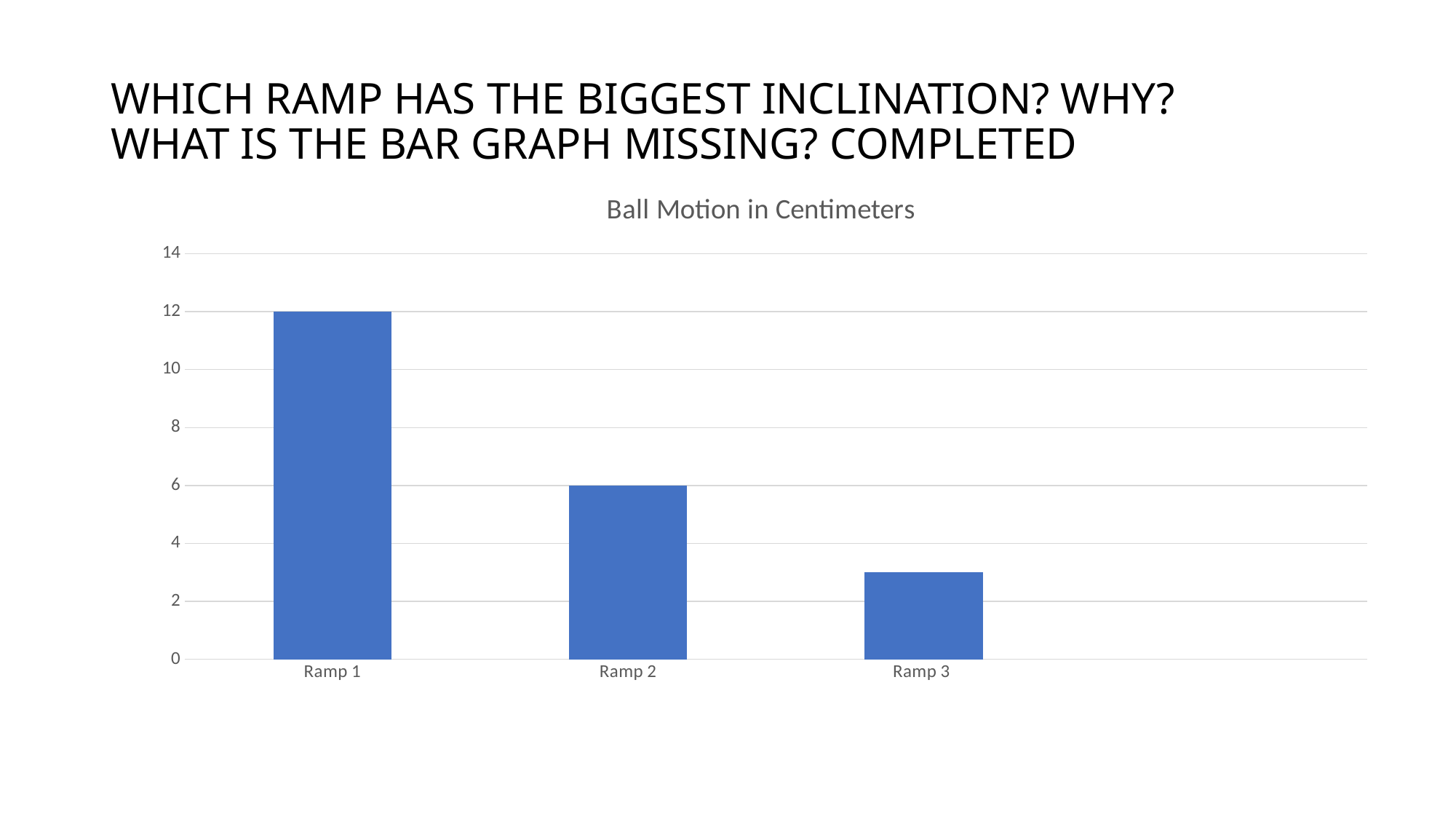
Which ramp has the lowest value? Ramp 3 How many ramps are shown on the x axis of the chart? 3 What is the value for Ramp 1? 12 Is the value for Ramp 3 greater or less than 4? less Is the value for Ramp 3 greater or less than 2? greater What is the difference between the values for Ramp 1 and Ramp 2? 6 Which ramp has the highest value? Ramp 1 What is the title of the chart? Ball Motion in Centimeters Do the values rise or fall from Ramp 1 to Ramp 3? fall What kind of chart is shown on the slide? bar chart What is the value for Ramp 2? 6 Which is larger, the value for Ramp 2 or the value for Ramp 3? Ramp 2